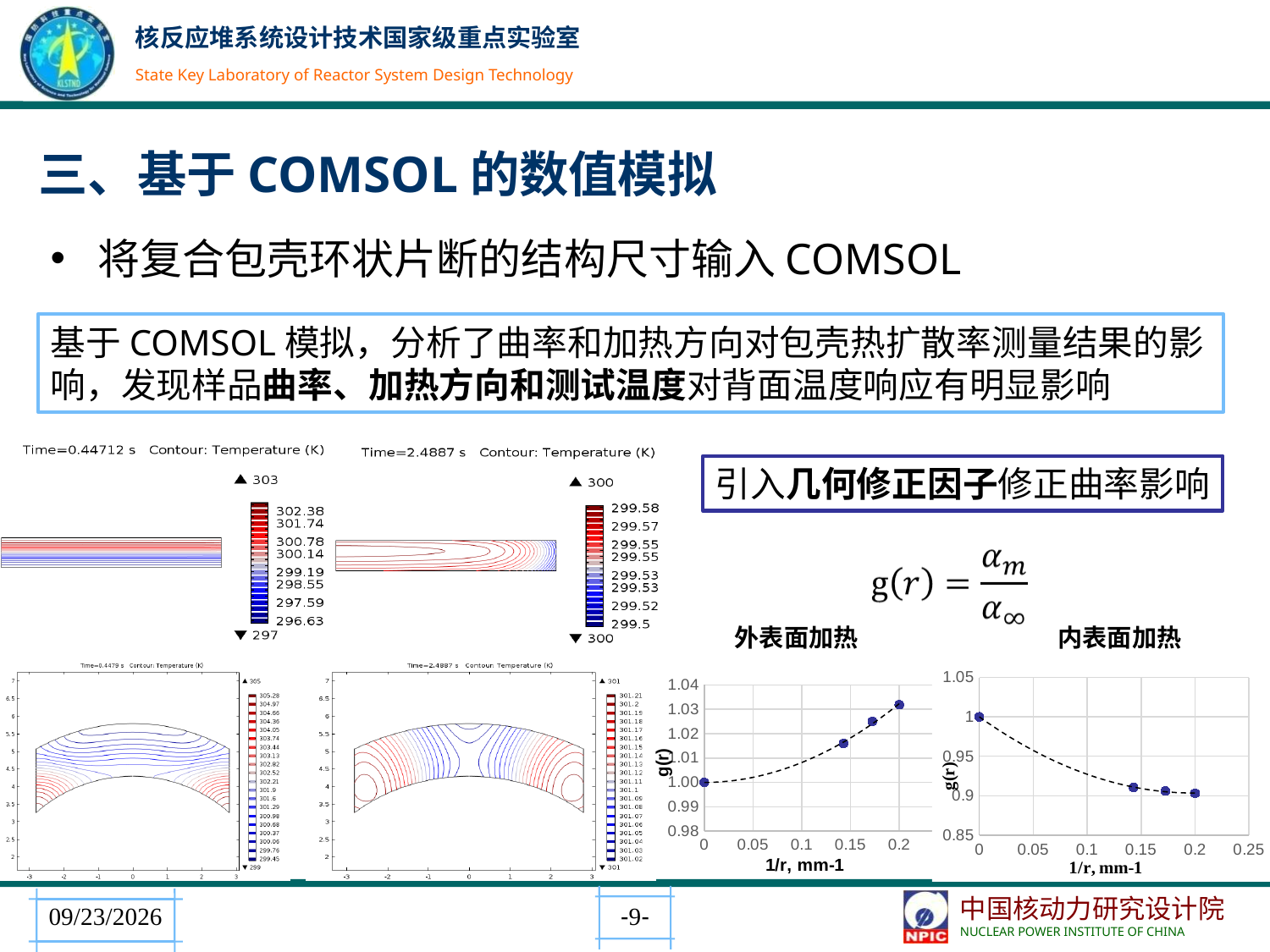
In the "内表面加热" chart, what is the value of g(r) at 1/r = 0? 1 In the "内表面加热" chart, is the value of g(r) at 1/r = 0.2 greater or less than 0.95? less In the "外表面加热" chart, is the value of g(r) at 1/r = 0.2 greater or less than 1.02? greater In the "内表面加热" chart, at which 1/r value is g(r) highest? 0 In the "外表面加热" chart, does g(r) rise or fall as 1/r increases? rise What kind of chart is the "外表面加热" chart? scatter chart How many data points are plotted in the "内表面加热" chart? 4 In the "外表面加热" chart, what is the value of g(r) at 1/r = 0? 1.00 What is the x-axis label of the "内表面加热" chart? 1/r, mm-1 How many data points are plotted in the "外表面加热" chart? 4 In the "内表面加热" chart, does g(r) rise or fall as 1/r increases? fall In the "外表面加热" chart, at which 1/r value is g(r) highest? 0.2